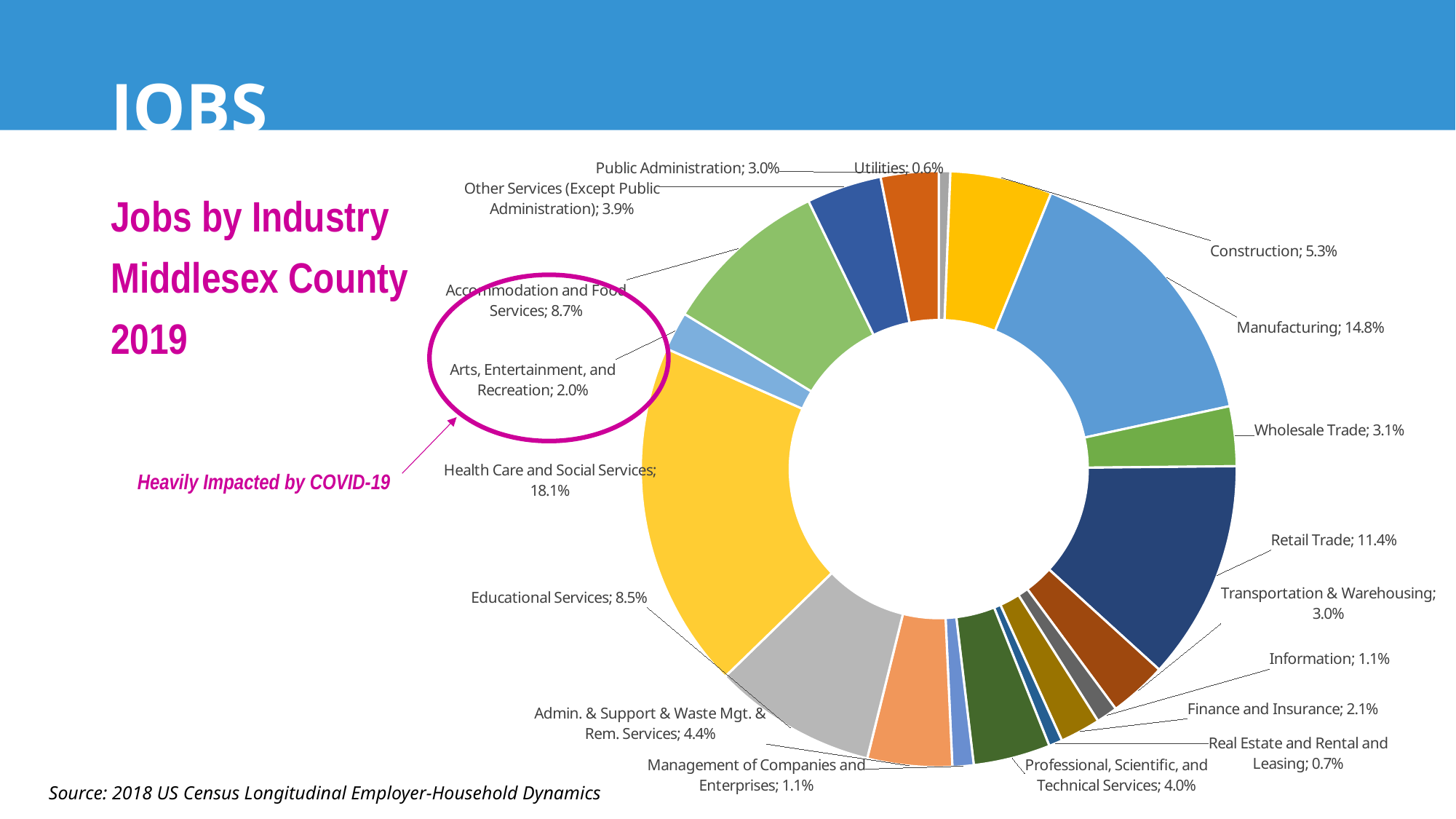
Which industry has the largest share of jobs? Health Care and Social Services What is the value shown for Arts, Entertainment, and Recreation? 2.0% What share of jobs is in Manufacturing? 14.8% Which has a larger share of jobs, Educational Services or Accommodation and Food Services? Accommodation and Food Services Which industry has the smallest share of jobs? Utilities What kind of chart is shown on the slide? doughnut chart Which two industries are circled as heavily impacted by COVID-19? Accommodation and Food Services; Arts, Entertainment, and Recreation What is the title of the chart? Jobs by Industry Middlesex County 2019 What share of jobs is in Health Care and Social Services? 18.1% What is the value shown for Accommodation and Food Services? 8.7% What is the difference in percentage points between Manufacturing and Retail Trade? 3.4 percentage points How many industry categories are shown in the chart? 18